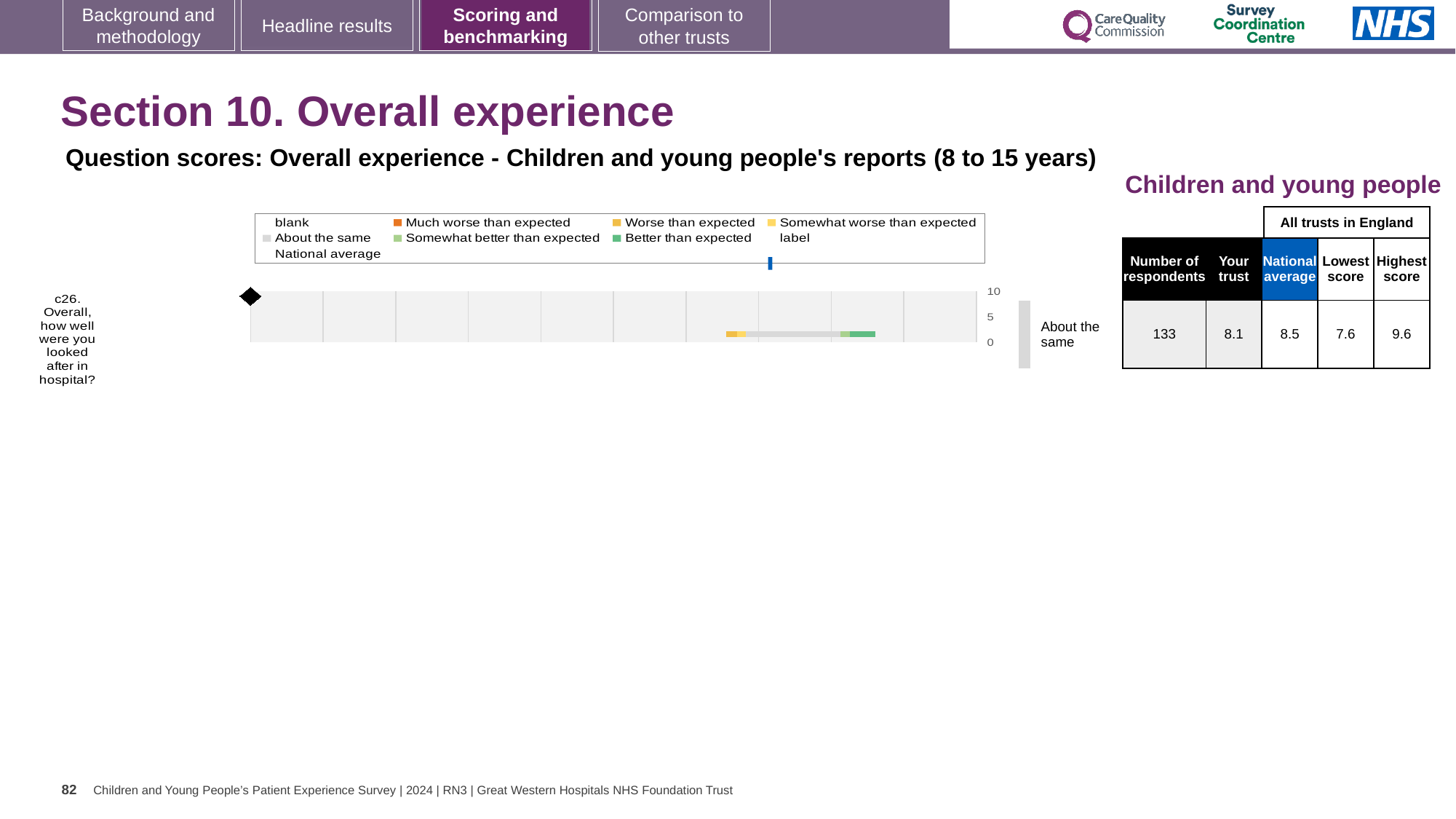
What is the lowest score among all trusts in England for question c26? 7.6 How many respondents answered question c26? 133 What is the difference between the highest and lowest scores for question c26? 2.0 Which is larger for question c26, the trust's score or the national average? National average How many survey questions are plotted on the chart? 1 What is the difference between the national average and the trust's score for question c26? 0.4 Which survey question is plotted on the chart? c26. Overall, how well were you looked after in hospital? What kind of chart is used to show the question score? Bar chart What is the 'Your trust' score for question c26? 8.1 What is the highest score among all trusts in England for question c26? 9.6 What benchmark category label is shown next to the chart for question c26? About the same What is the national average score for question c26? 8.5